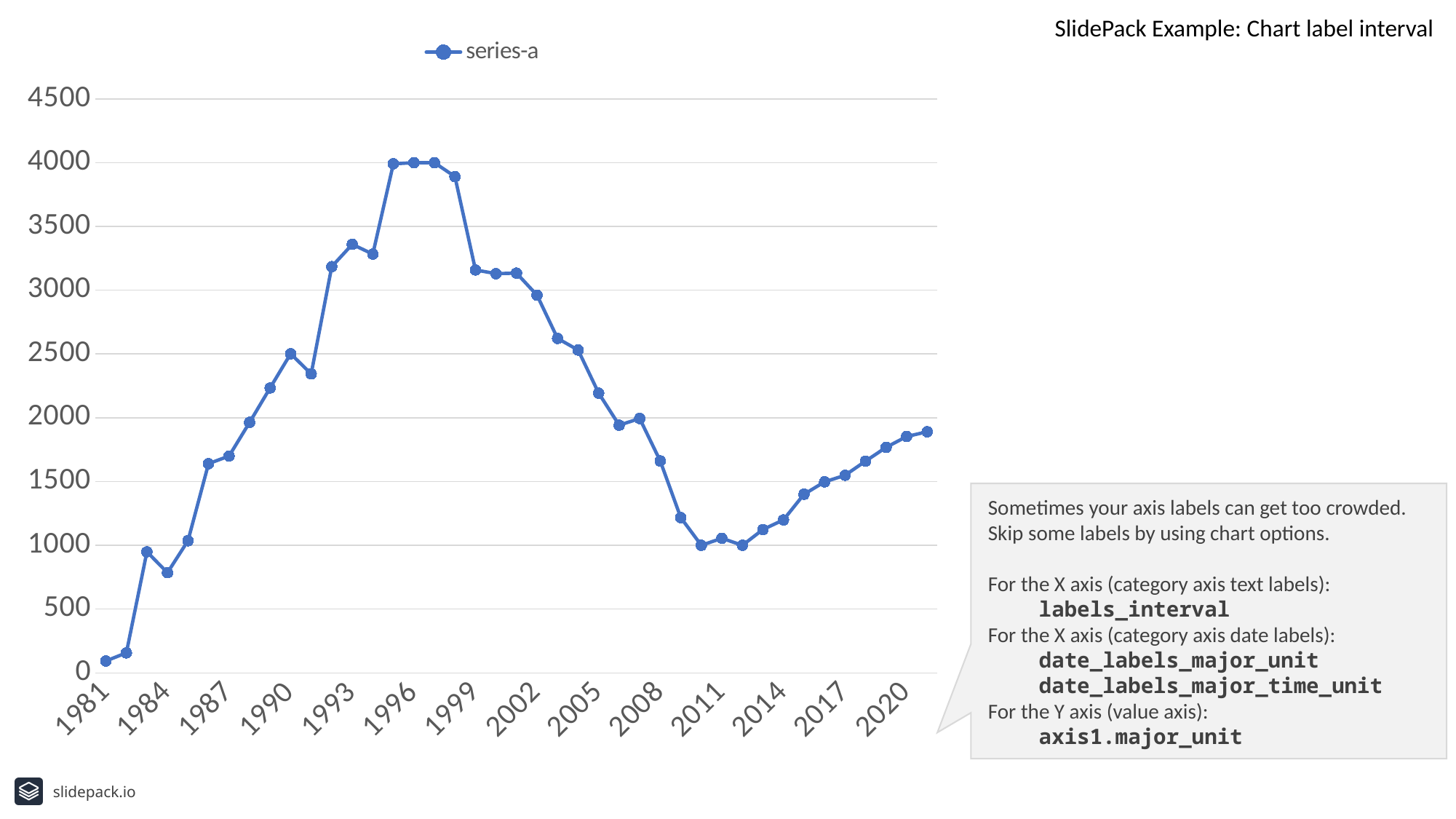
Which year has the larger value for series-a, 1993 or 2005? 1993 What is the name of the series shown in the chart legend? series-a Is the value for series-a in 1981 greater or less than 500? less Do the values for series-a rise or fall between 1999 and 2011? fall Is the value for series-a in 1996 greater or less than 3500? greater How many year labels are shown on the x axis of the chart? 14 Is the value for series-a in 1984 greater or less than 1000? less What kind of chart is shown on the slide? line chart How many series does the chart legend list? 1 Which year on the x axis has the lowest value for series-a? 1981